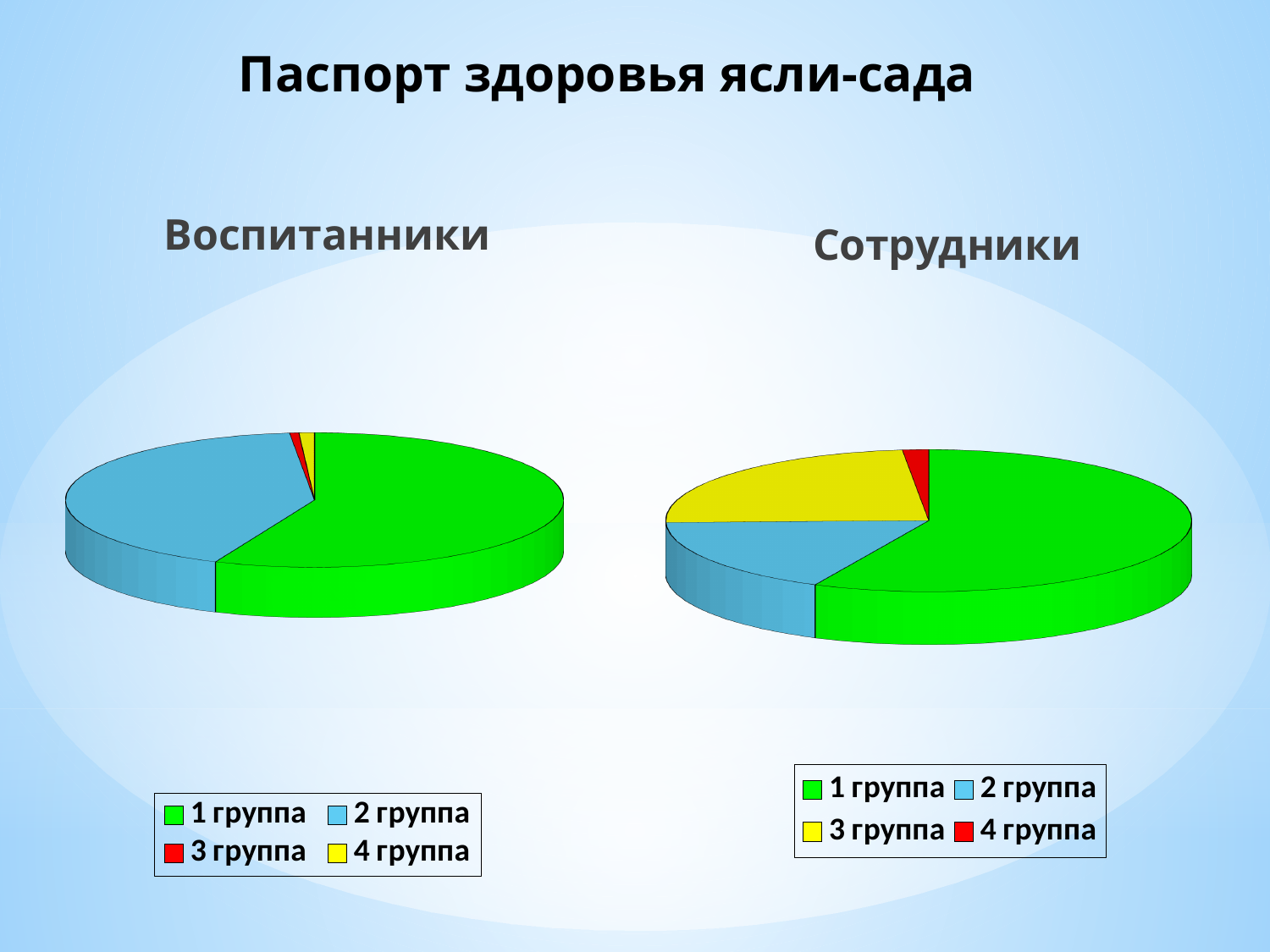
In the "Сотрудники" chart, which slice is larger: 3 группа or 4 группа? 3 группа What kind of chart is the "Сотрудники" chart on the right? pie chart How many slices does the "Воспитанники" pie chart have? 4 In the "Сотрудники" chart, what colour represents 3 группа? yellow In the "Воспитанники" chart, which slice is larger: 2 группа or 3 группа? 2 группа How many entries does the legend of the "Сотрудники" chart list? 4 In the "Воспитанники" chart, which group has the largest slice? 1 группа In the "Воспитанники" chart, which slice is larger: 1 группа or 2 группа? 1 группа In the "Сотрудники" chart, which group has the smallest slice? 4 группа What kind of chart is the "Воспитанники" chart on the left? pie chart What is the title of the slide containing the two pie charts? Паспорт здоровья ясли-сада In the "Сотрудники" chart, which group has the largest slice? 1 группа